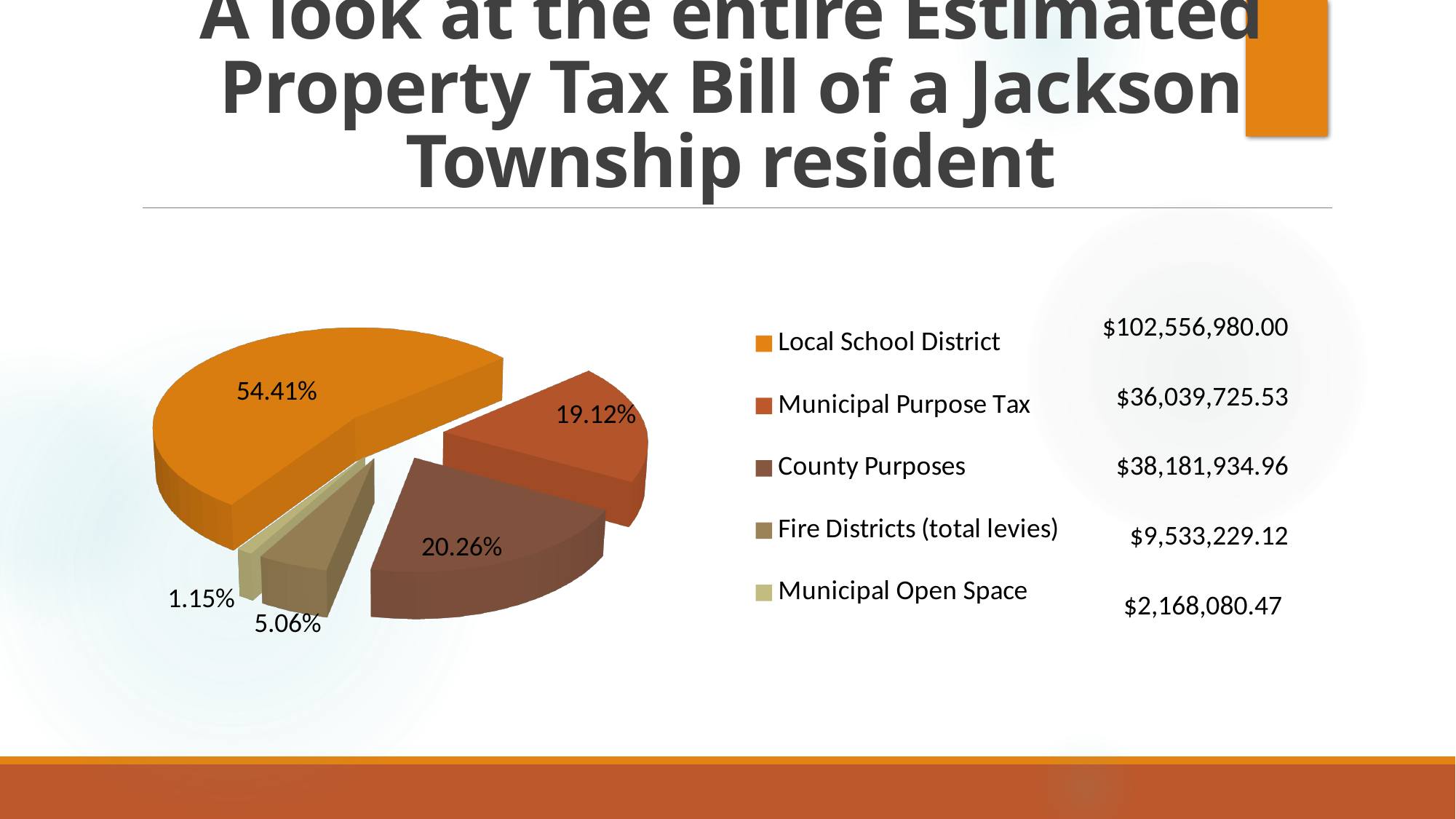
What dollar amount is listed next to Municipal Open Space in the legend? $2,168,080.47 What is the difference in percentage points between the Local School District share and the County Purposes share? 34.15 What kind of chart is shown on the slide? pie chart What share of the pie does Fire Districts (total levies) represent? 5.06% What share of the pie does Local School District represent? 54.41% How many slices does the pie chart have? 5 Which is larger, the share for County Purposes or the share for Municipal Purpose Tax? County Purposes What share of the pie does Municipal Purpose Tax represent? 19.12% What dollar amount is listed next to Municipal Purpose Tax in the legend? $36,039,725.53 Which category has the smallest slice of the pie? Municipal Open Space Which category has the largest slice of the pie? Local School District